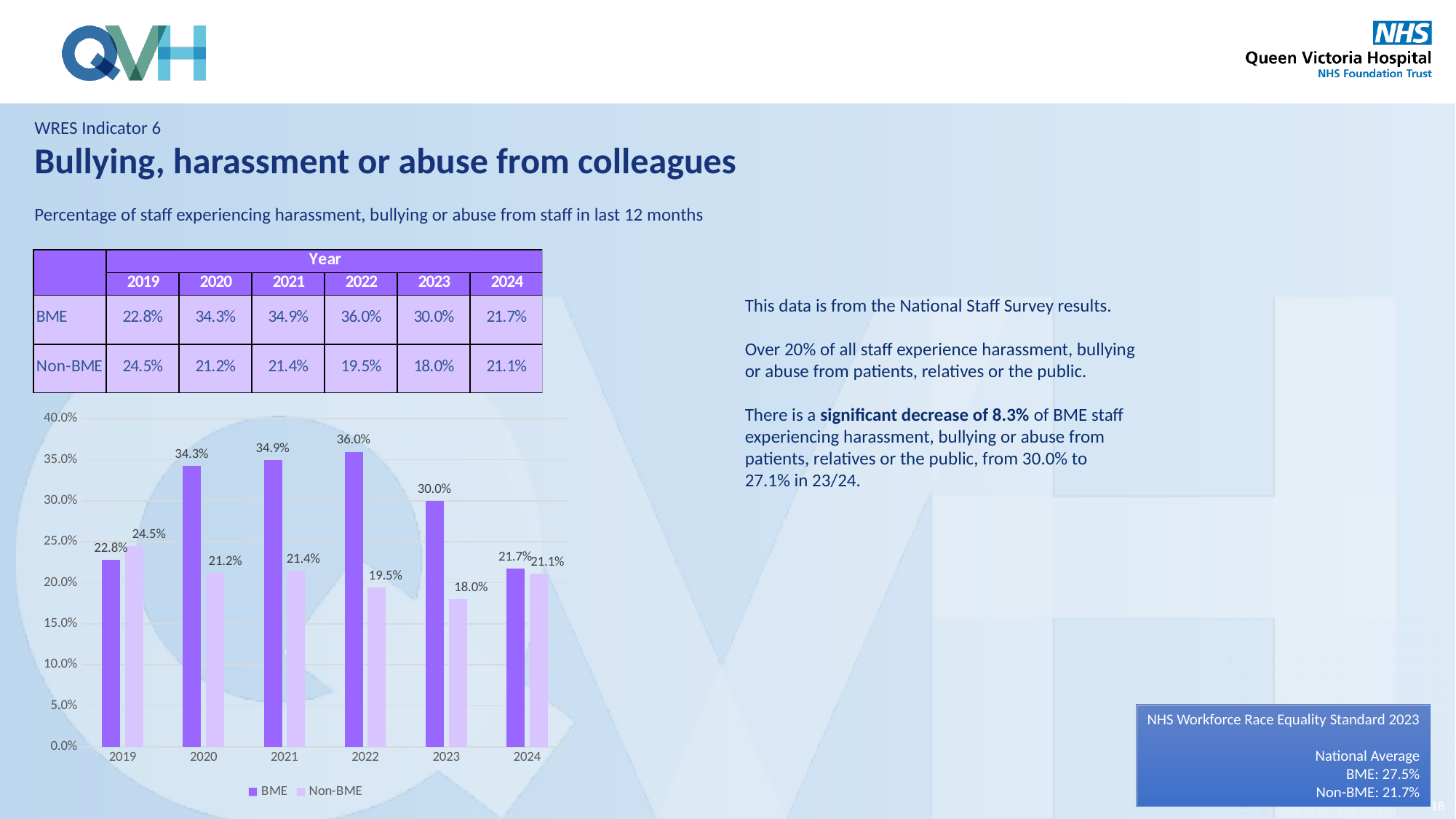
Which is larger in 2019, the BME value or the Non-BME value? Non-BME What are the two series named in the chart legend? BME and Non-BME How many years are shown on the x axis of the chart? 6 What is the Non-BME value for 2023? 18.0% What is the difference between the BME and Non-BME values in 2022? 16.5% What is the BME value for 2019? 22.8% What kind of chart is shown on the slide? Bar chart Does the BME value rise or fall from 2022 to 2024? Fall In which year is the Non-BME value lowest? 2023 How many series does the chart legend list? 2 What is the BME value for 2022? 36.0% In which year is the BME value highest? 2022